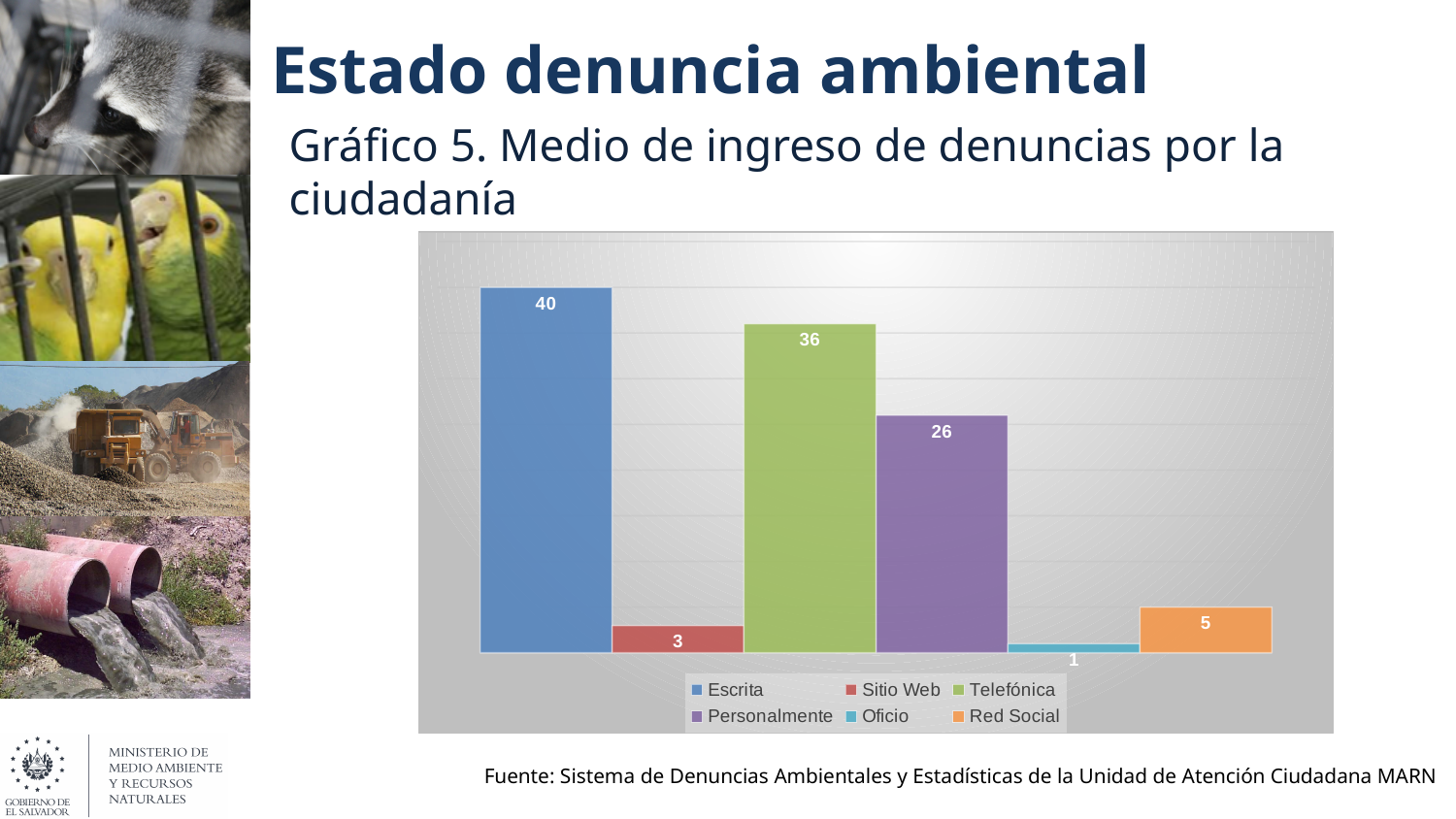
What is the difference between the values for Red Social and Sitio Web? 2 What is the difference between the values for Escrita and Telefónica? 4 What is the value for Red Social? 5 How many categories does the legend list? 6 What is the title of the chart? Gráfico 5. Medio de ingreso de denuncias por la ciudadanía What is the value for Escrita? 40 What is the value for Telefónica? 36 What kind of chart is shown on the slide? Bar chart Which is larger, the value for Personalmente or the value for Telefónica? Telefónica Which category has the highest value? Escrita What is the value for Personalmente? 26 Which category has the lowest value? Oficio